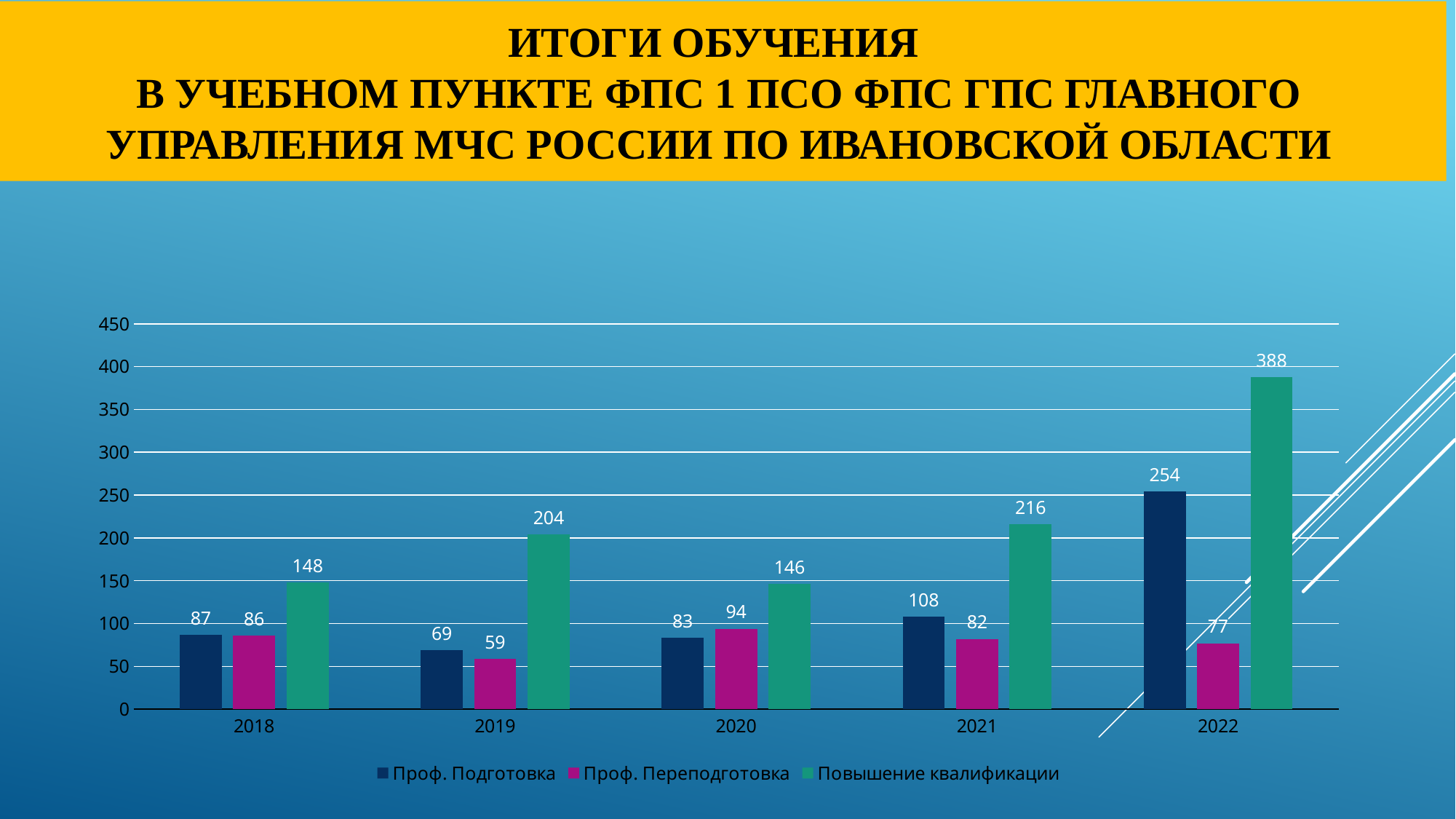
Which is larger in 2020: Проф. Подготовка or Проф. Переподготовка? Проф. Переподготовка Does Повышение квалификации rise or fall from 2020 to 2022? rise What kind of chart is shown on the slide? bar chart In which year is Проф. Переподготовка lowest? 2019 What is the value for Повышение квалификации in 2019? 204 Is the value for Повышение квалификации in 2022 greater or less than 350? greater What is the difference between Повышение квалификации in 2022 and in 2021? 172 What is the value for Проф. Подготовка in 2022? 254 How many years are shown on the x axis? 5 How many series does the legend list? 3 What is the value for Проф. Переподготовка in 2020? 94 In which year is Повышение квалификации highest? 2022